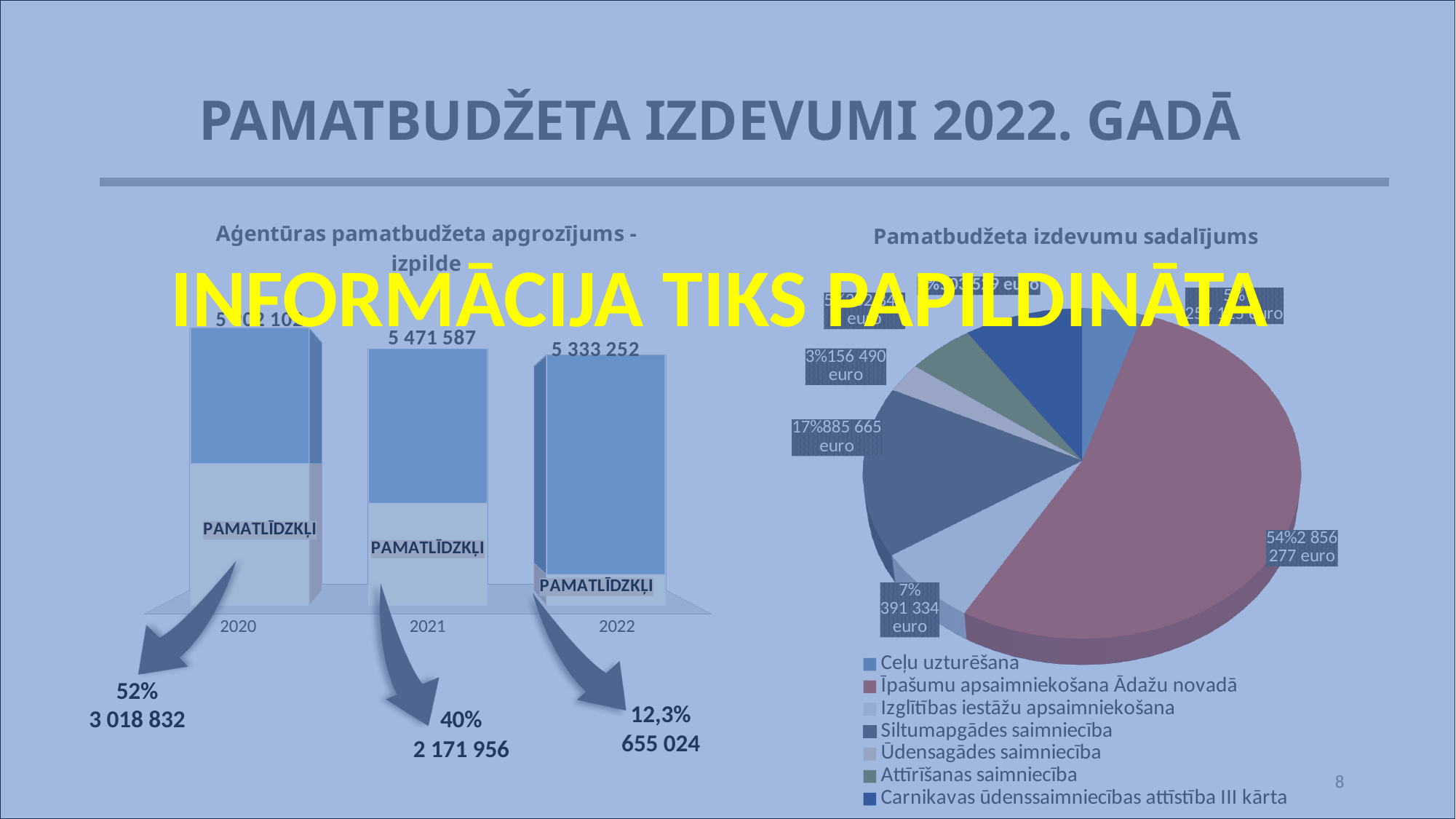
How many years are shown in the bar chart 'Aģentūras pamatbudžeta apgrozījums - izpilde'? 3 In the bar chart 'Aģentūras pamatbudžeta apgrozījums - izpilde', which year has the larger total value, 2021 or 2022? 2021 In the bar chart on the left, what percentage is shown for PAMATLĪDZEKĻI in 2022? 12,3% In the bar chart 'Aģentūras pamatbudžeta apgrozījums - izpilde', what is the difference between the 2021 and 2022 values? 138 335 In the bar chart on the left, does the PAMATLĪDZEKĻI percentage rise or fall from 2020 to 2022? fall In the bar chart 'Aģentūras pamatbudžeta apgrozījums - izpilde', what is the value for 2022? 5 333 252 In the bar chart on the left, what amount is shown for PAMATLĪDZEKĻI in 2022? 655 024 In the pie chart 'Pamatbudžeta izdevumu sadalījums', what share does the largest slice have? 54% In the bar chart 'Aģentūras pamatbudžeta apgrozījums - izpilde', what is the value for 2021? 5 471 587 In the bar chart on the left, what percentage is shown for PAMATLĪDZEKĻI in 2020? 52% How many entries does the legend of the pie chart 'Pamatbudžeta izdevumu sadalījums' list? 7 In the bar chart on the left, what amount is shown for PAMATLĪDZEKĻI in 2021? 2 171 956